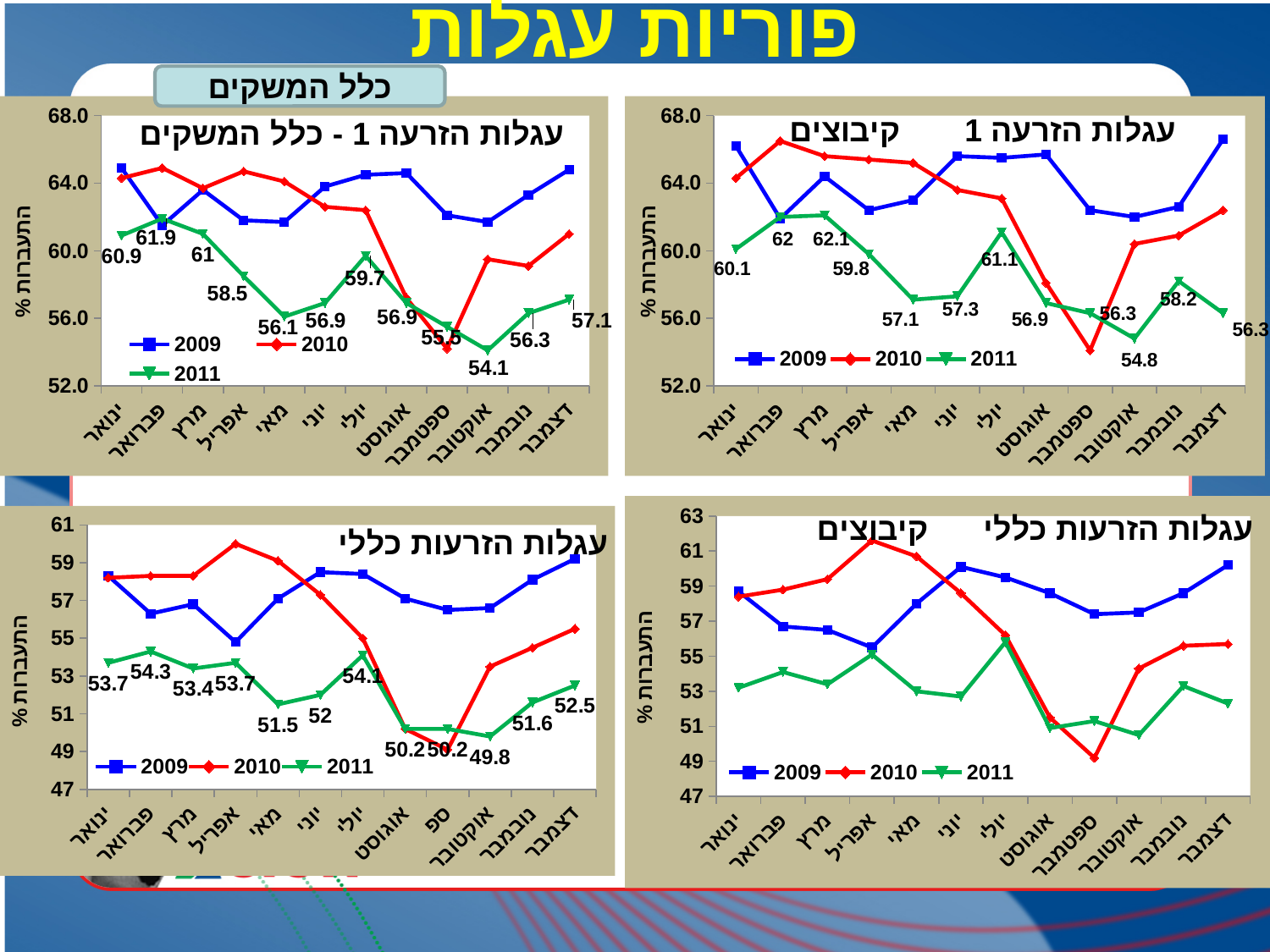
In the bottom-right chart (עגלות הזרעות כללי קיבוצים), is the 2010 value for April (אפריל) greater or less than 61? greater In the top-left chart (עגלות הזרעה 1 - כלל המשקים), what is the difference between the 2011 values for February (פברואר) and October (אוקטובר)? 7.8 In the top-left chart (עגלות הזרעה 1 - כלל המשקים), what is the 2011 value for January (ינואר)? 60.9 In the bottom-left chart (עגלות הזרעות כללי), which month has the lowest labelled 2011 value? October (אוקטובר), 49.8 In the top-right chart (עגלות הזרעה 1 קיבוצים), is the 2011 value for October (אוקטובר) greater or less than the 2011 value for November (נובמבר)? less In the top-left chart (עגלות הזרעה 1 - כלל המשקים), which month has the lowest labelled 2011 value? October (אוקטובר), 54.1 How many series does the legend list in the bottom-right chart (עגלות הזרעות כללי קיבוצים)? 3 What type of chart is the top-left chart (עגלות הזרעה 1 - כלל המשקים)? Line chart In the top-right chart (עגלות הזרעה 1 קיבוצים), what is the 2011 value for July (יולי)? 61.1 In the bottom-left chart (עגלות הזרעות כללי), what is the 2011 value for December (דצמבר)? 52.5 In the top-right chart (עגלות הזרעה 1 קיבוצים), which month has the highest labelled 2011 value? March (מרץ), 62.1 In the bottom-left chart (עגלות הזרעות כללי), what is the difference between the 2011 values for February (פברואר) and March (מרץ)? 0.9